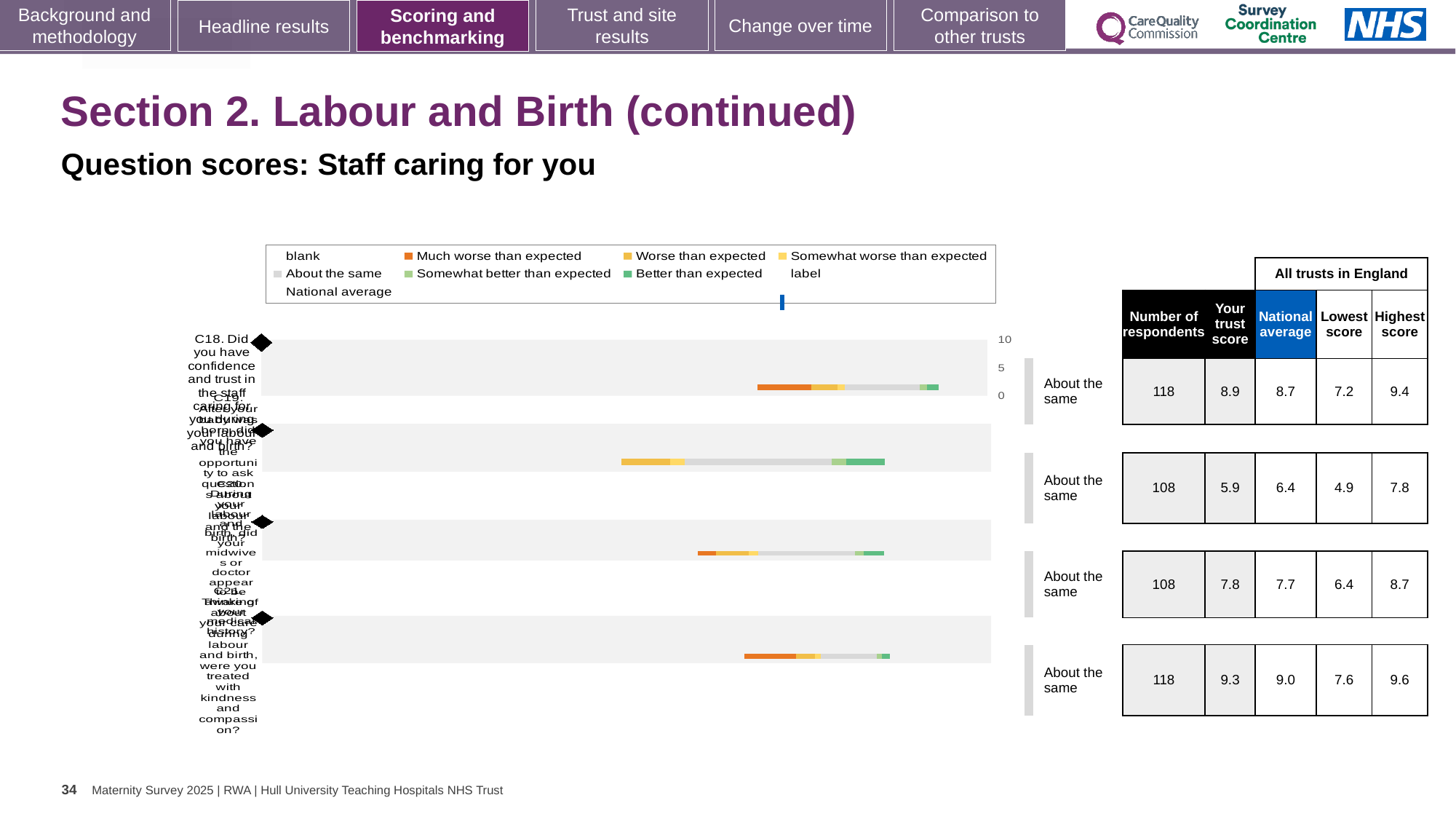
What kind of chart is used to show the question scores on this slide? bar chart What is the difference between the trust score and the national average for question C18? 0.2 How many questions (bars) are plotted in the chart? 4 What is the highest score among all trusts in England for question C21 (treated with kindness and compassion)? 9.6 For question C21, which is larger: the trust score or the national average? the trust score (9.3) Which question has the highest 'Your trust score' in the table? C21 (treated with kindness and compassion) What is the national average for question C18 (confidence and trust in the staff caring for you)? 8.7 What is the 'Your trust score' for question C18 (confidence and trust in the staff caring for you)? 8.9 What benchmark category is shown next to each of the four questions in the chart? About the same How many respondents answered question C18 (confidence and trust in the staff caring for you)? 118 What is the 'Your trust score' for question C21 (treated with kindness and compassion during labour and birth)? 9.3 What is the lowest 'Your trust score' shown in the table? 5.9